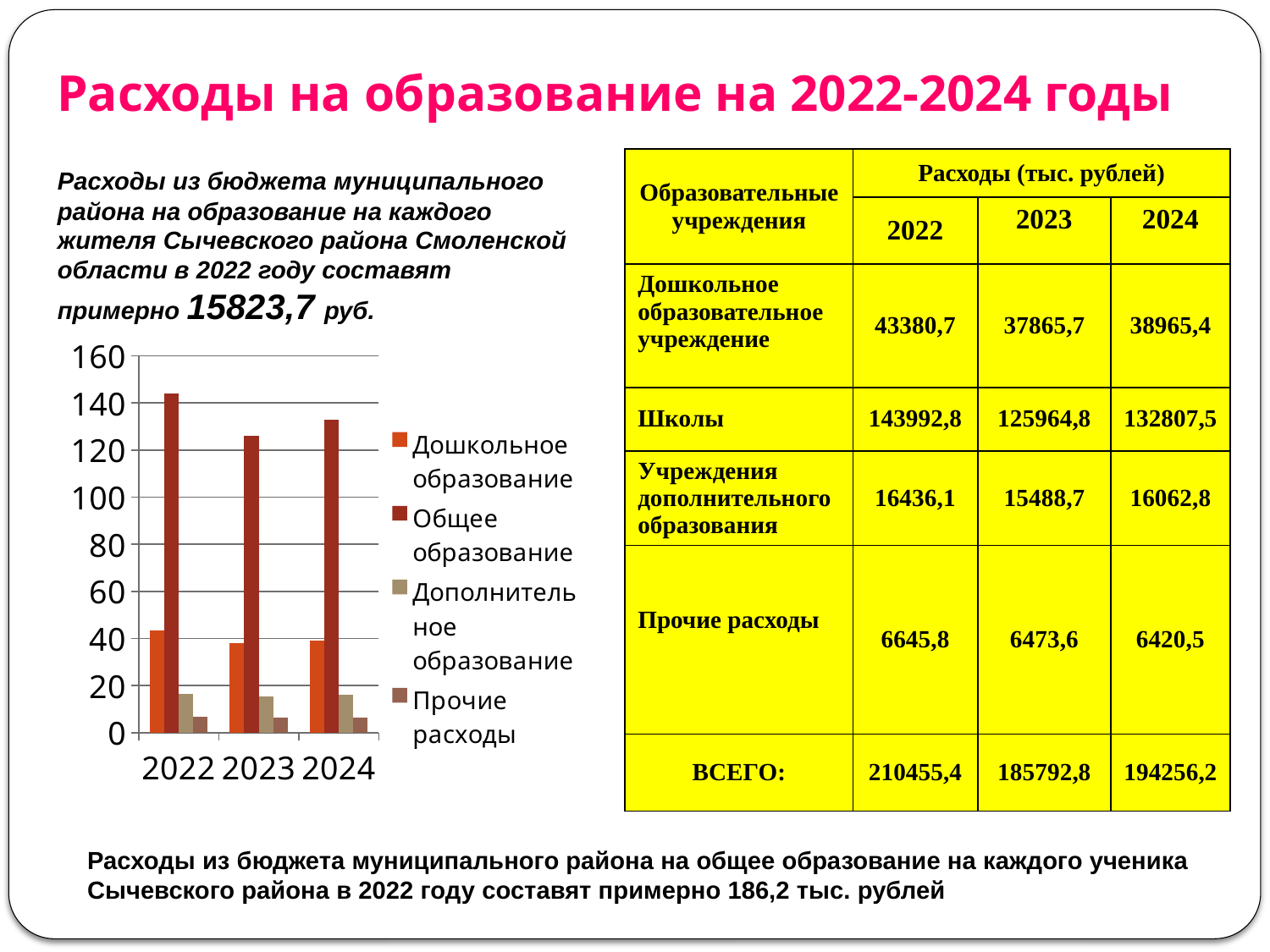
Is the value for Дополнительное образование in 2023 greater or less than 20? less What kind of chart is shown on the slide? bar chart Is the value for Дошкольное образование in 2022 greater or less than 40? greater What is the highest tick value shown on the chart's vertical axis? 160 Does the value for Общее образование rise or fall from 2022 to 2023? fall Is the value for Общее образование in 2023 greater or less than 140? less How many series does the chart legend list? 4 Which series has the tallest bar in 2022? Общее образование How many years (categories) are shown on the x axis of the chart? 3 Which series has the shortest bar in 2024? Прочие расходы Which is larger for Общее образование: the 2022 bar or the 2023 bar? 2022